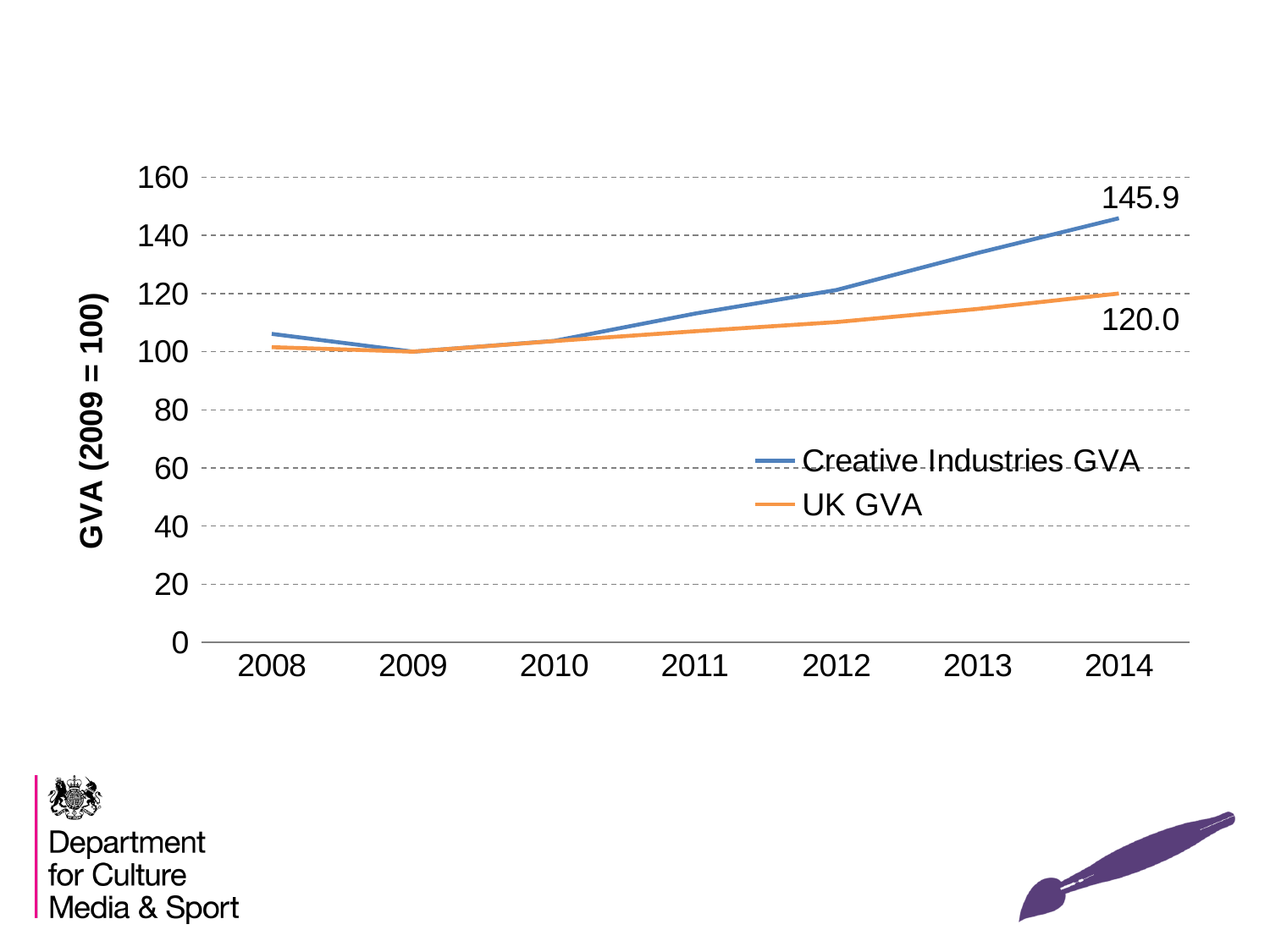
How many years are shown on the x axis? 7 How many series does the legend list? 2 Is the value for Creative Industries GVA in 2013 greater or less than 120? greater Is the value for Creative Industries GVA in 2012 greater or less than 140? less What kind of chart is shown on the slide? line chart What is the difference between Creative Industries GVA and UK GVA in 2014? 25.9 Which series has the higher value in 2014, Creative Industries GVA or UK GVA? Creative Industries GVA What is the value of Creative Industries GVA in 2014? 145.9 Does Creative Industries GVA rise or fall between 2009 and 2014? rise What is the value of UK GVA in 2014? 120.0 Is the value for UK GVA in 2013 greater or less than 100? greater What is the label of the y axis? GVA (2009 = 100)